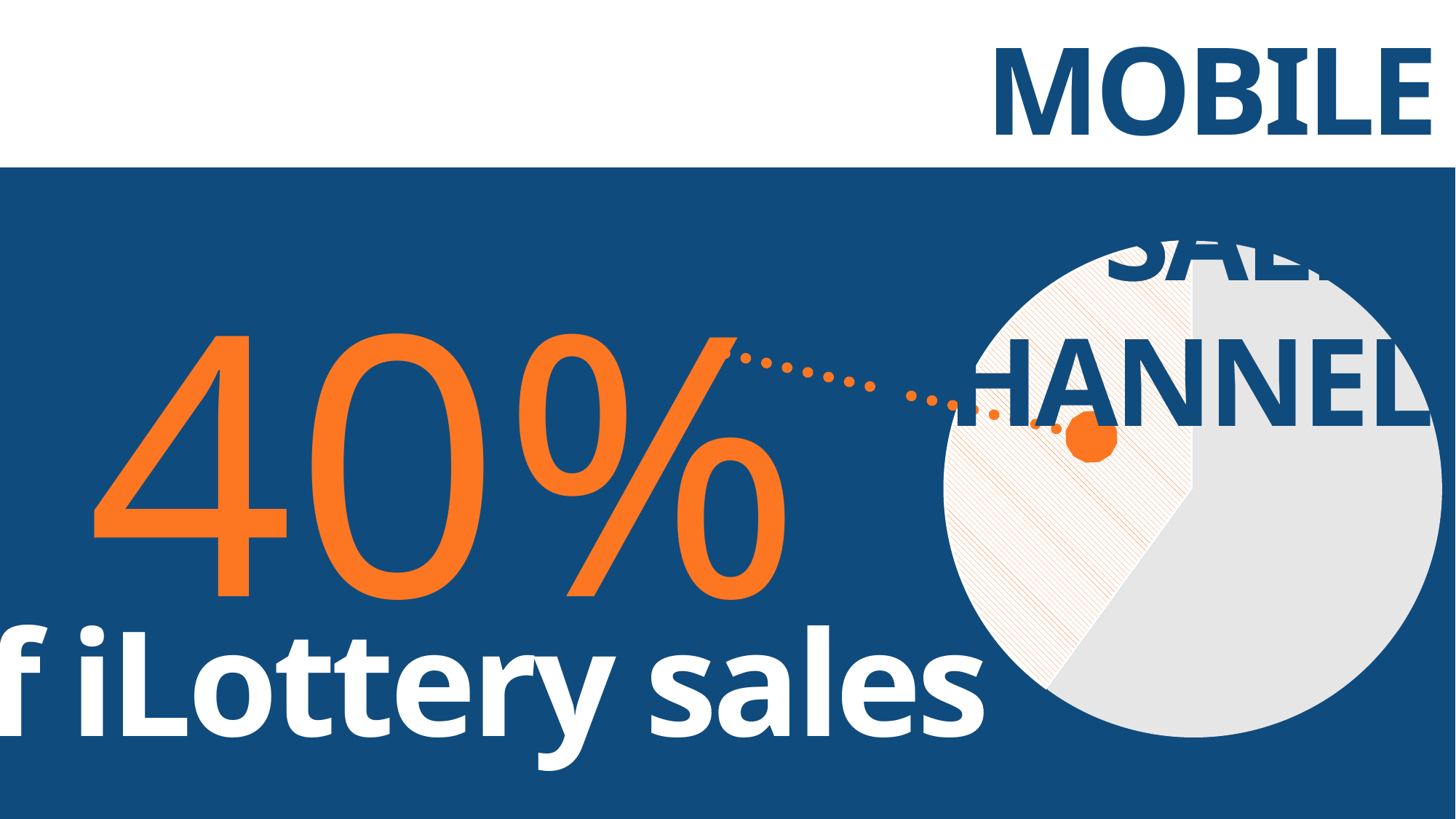
Is the share of the orange hatched slice greater or less than 50%? less What share of iLottery sales does the highlighted (orange hatched) slice of the pie chart represent? 40% What share of the pie chart does the grey slice represent? 60% Which slice of the pie chart is larger, the orange hatched slice or the grey slice? the grey slice What kind of chart is shown on the slide? pie chart What does the 40% figure on the slide refer to? iLottery sales Which slice of the pie chart is the smallest? the orange hatched slice (40%) How many slices does the pie chart have? 2 What word appears as the heading at the top right of the slide? MOBILE